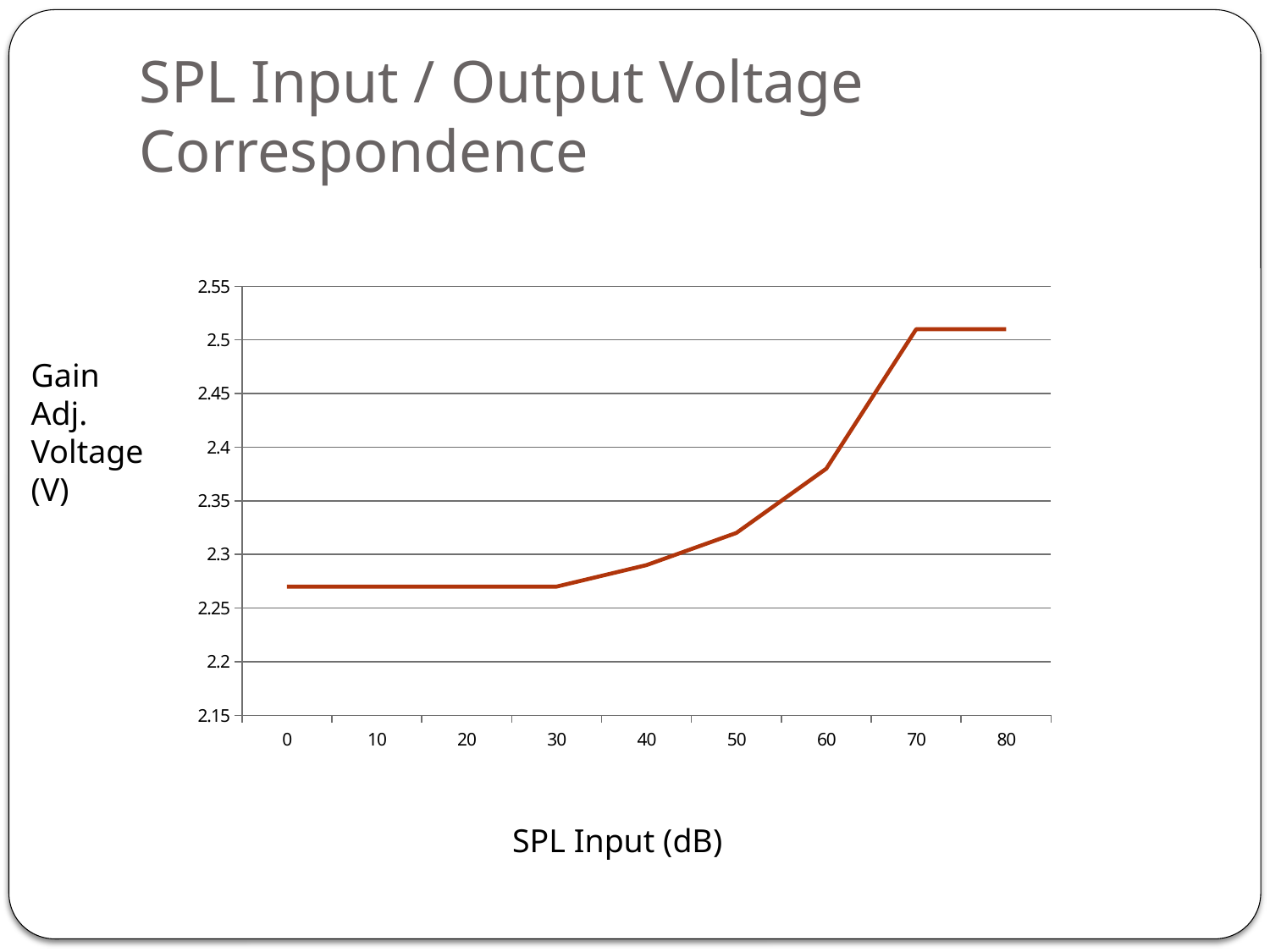
What kind of chart is shown on the slide? line chart What is the title of the chart on the slide? SPL Input / Output Voltage Correspondence Do the values generally rise or fall as SPL Input increases from 0 to 80 dB? rise Is the value for SPL Input 70 dB greater or less than 2.45? greater Which has the larger value, SPL Input 30 dB or SPL Input 60 dB? 60 dB Is the value for SPL Input 80 dB greater or less than 2.45? greater How many data points are plotted along the x axis? 9 Is the value for SPL Input 60 dB greater or less than 2.35? greater Which has the larger value, SPL Input 50 dB or SPL Input 70 dB? 70 dB What is the title of the x axis? SPL Input (dB)